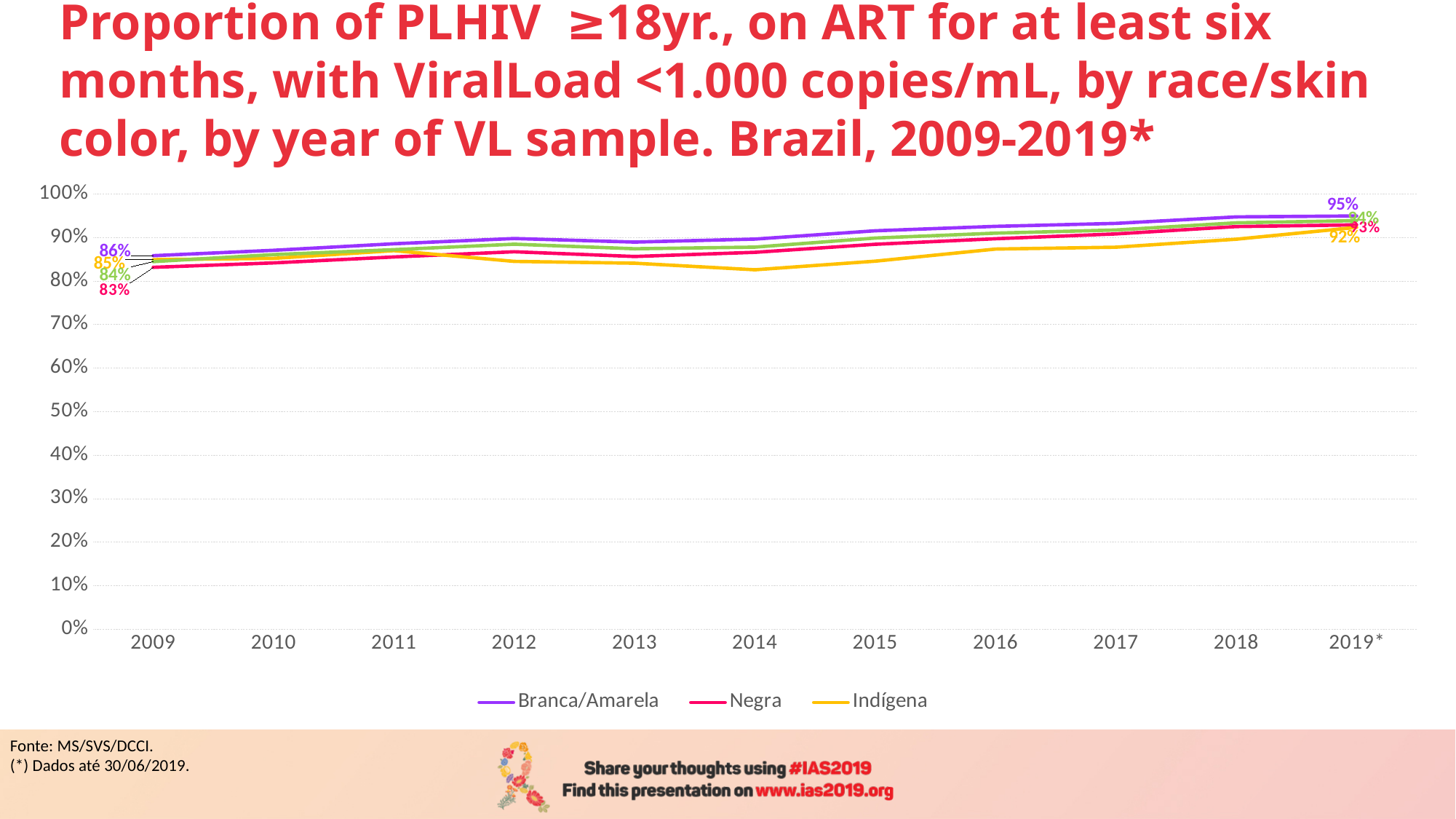
What kind of chart is shown on the slide? line chart What is the value for Negra in 2009? 83% In 2009, which is larger: the value for Branca/Amarela or the value for Negra? Branca/Amarela What is the value for Branca/Amarela in 2019*? 95% Which series has the highest value in 2019*? Branca/Amarela What is the value for Negra in 2019*? 93% What is the value for Branca/Amarela in 2009? 86% By how many percentage points did the Branca/Amarela value change from 2009 to 2019*? 9 percentage points What is the value for Indígena in 2019*? 92% Which series has the lowest value in 2009? Negra How many series does the legend list? 3 Is the value for Indígena in 2014 greater or less than 90%? less